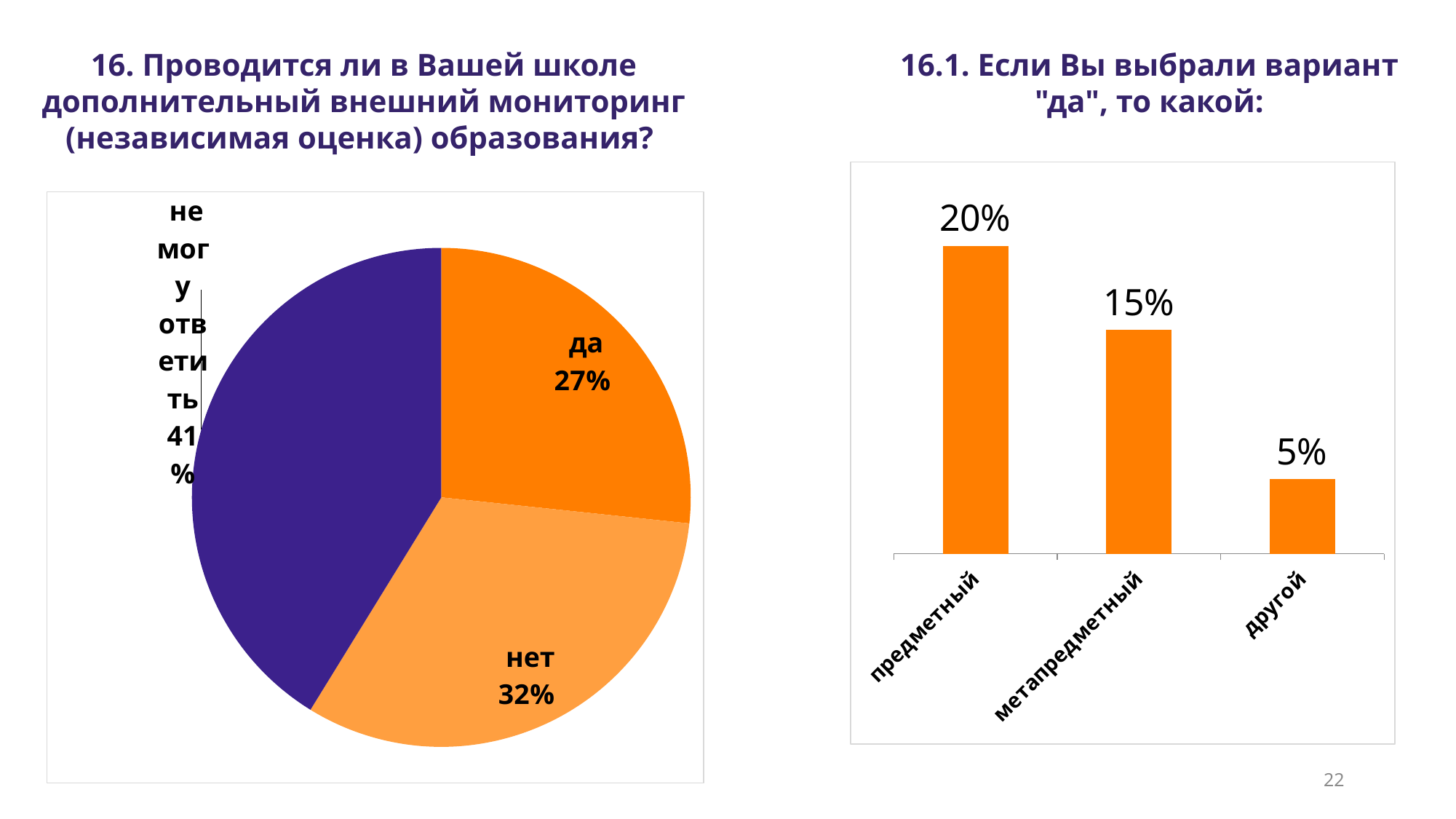
In the left pie chart (question 16), which answer has the smallest share? да In the right chart (question 16.1), what is the value for "метапредметный"? 15% In the left pie chart (question 16), which answer has the largest share? не могу ответить What type of chart is shown on the left side of the slide (question 16)? pie chart In the left pie chart (question 16), what share of respondents answered "да"? 27% In the left pie chart (question 16), how many percentage points larger is "нет" than "да"? 5 In the left pie chart (question 16), what share of respondents answered "нет"? 32% In the left pie chart (question 16), what share of respondents answered "не могу ответить"? 41% In the left pie chart (question 16), how many slices does the pie have? 3 In the right chart (question 16.1), what is the difference between "предметный" and "другой"? 15 percentage points In the right chart (question 16.1), what is the value for "предметный"? 20% In the right chart (question 16.1), which category has the lowest value? другой